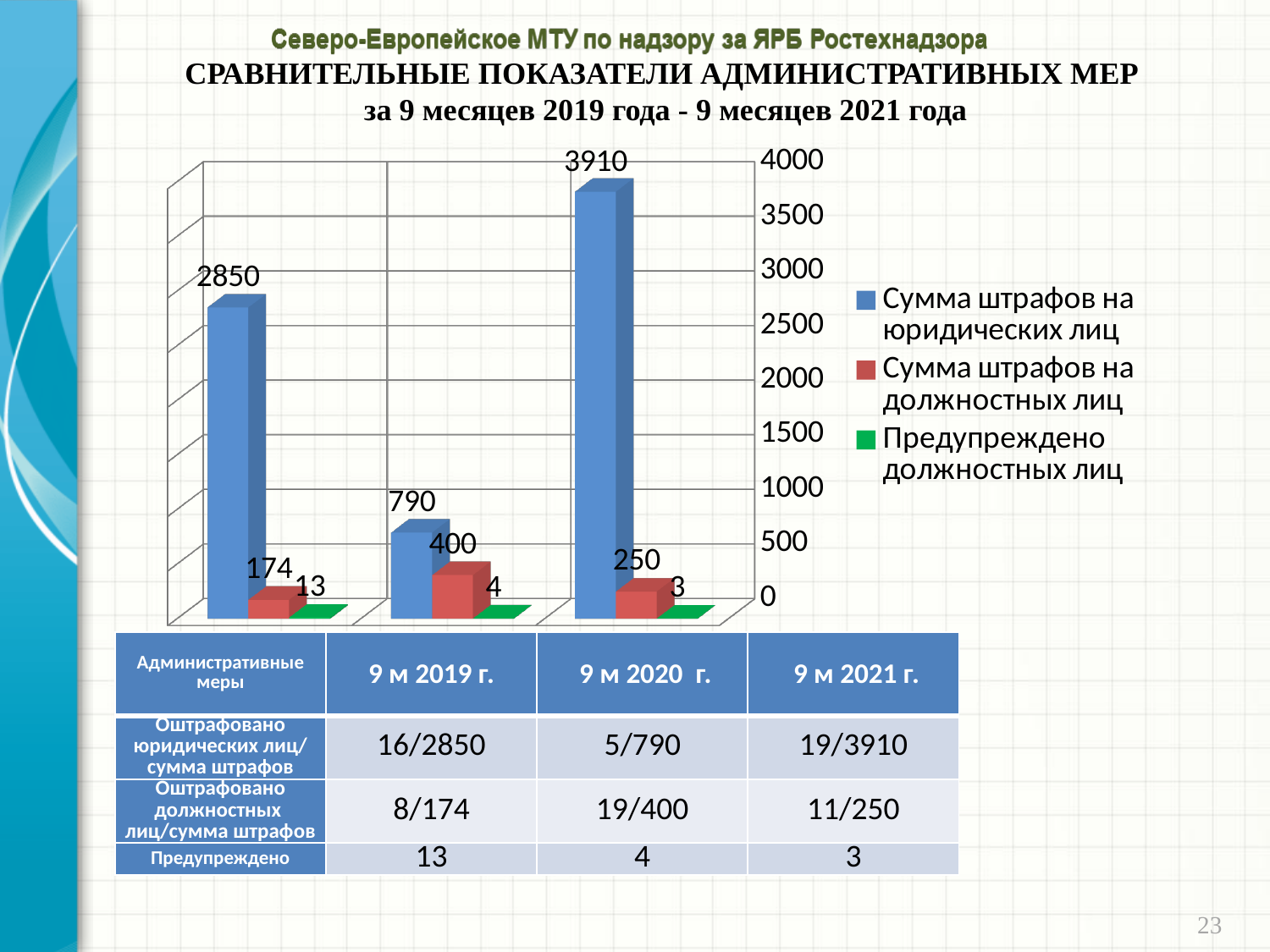
What is the value of the 'Сумма штрафов на должностных лиц' bar in the second group (9 м 2020 г.)? 400 How many series does the chart legend list? 3 What is the difference between the 'Сумма штрафов на юридических лиц' values in the third group (3910) and the second group (790)? 3120 Which group has the lowest 'Сумма штрафов на должностных лиц' value? the first group (9 м 2019 г.), 174 What kind of chart is shown on the slide? bar chart How many groups of bars are plotted in the chart? 3 Which group has the highest 'Сумма штрафов на юридических лиц' value? the third group (9 м 2021 г.), 3910 Is the 'Сумма штрафов на юридических лиц' value in the first group greater or less than 3000? less What is the value of the 'Предупреждено должностных лиц' bar in the third group (9 м 2021 г.)? 3 What is the value of the 'Сумма штрафов на юридических лиц' bar in the first group (9 м 2019 г.)? 2850 Which is larger: 'Сумма штрафов на должностных лиц' in the second group or in the third group? the second group (400) Which colour represents 'Предупреждено должностных лиц' in the chart? green